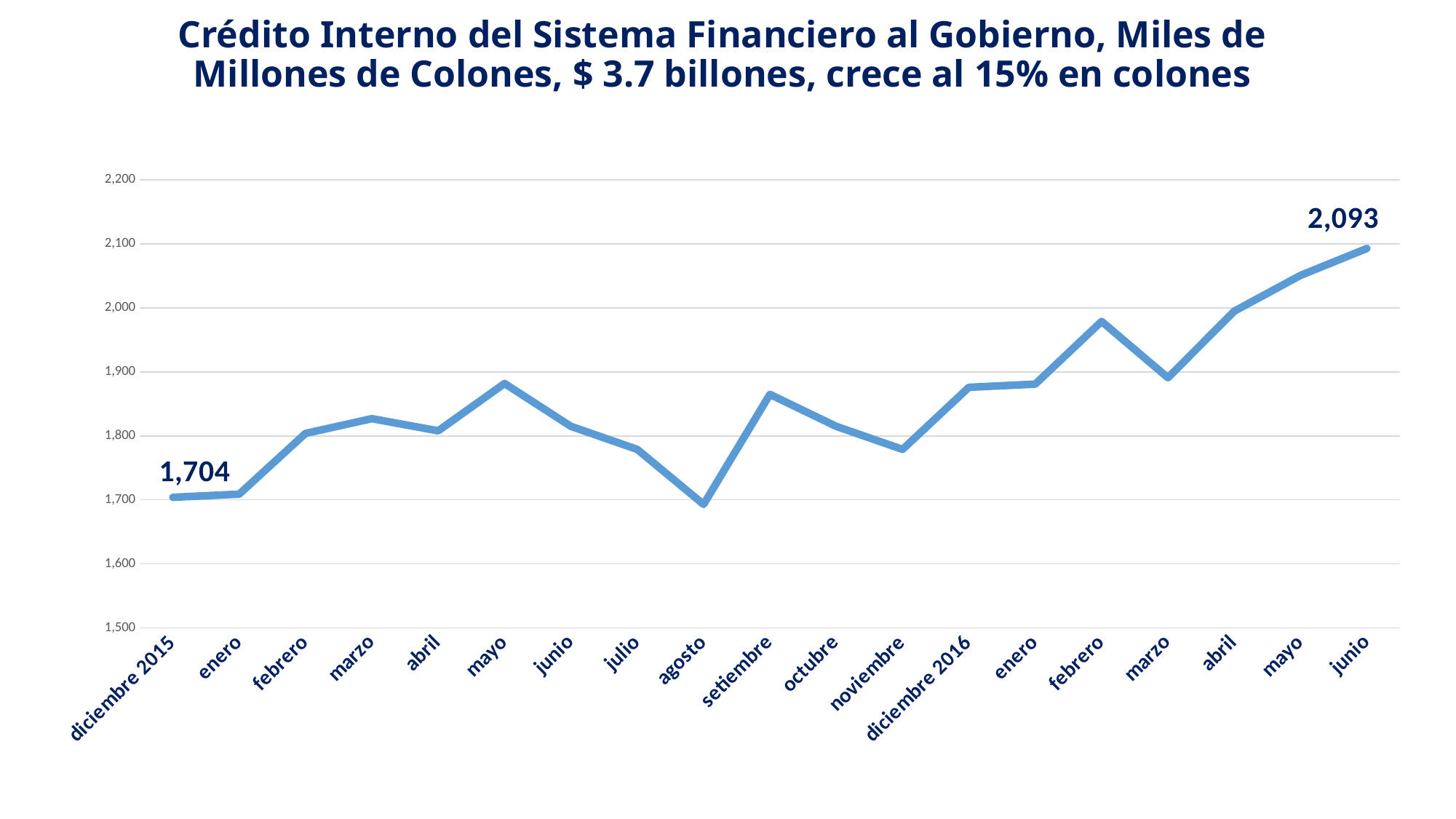
What is the difference between the value at the last point (junio) and the value at diciembre 2015? 389 How many data points are plotted on the line? 19 Is the value for the febrero that follows diciembre 2016 greater or less than 1,900? greater Which is higher: the value for the febrero after diciembre 2016 or the value for the marzo after diciembre 2016? febrero What is the value for diciembre 2015? 1,704 Which month has the highest value on the chart? junio (the last point) Is the value for agosto greater or less than 1,800? less What is the value for the final point, junio (the last month on the x axis)? 2,093 What type of chart is shown on the slide? line chart Is the value for the mayo that follows diciembre 2015 greater or less than 1,800? greater Overall, do the values rise or fall from diciembre 2015 to the final junio? rise What is the title of the chart? Crédito Interno del Sistema Financiero al Gobierno, Miles de Millones de Colones, $ 3.7 billones, crece al 15% en colones